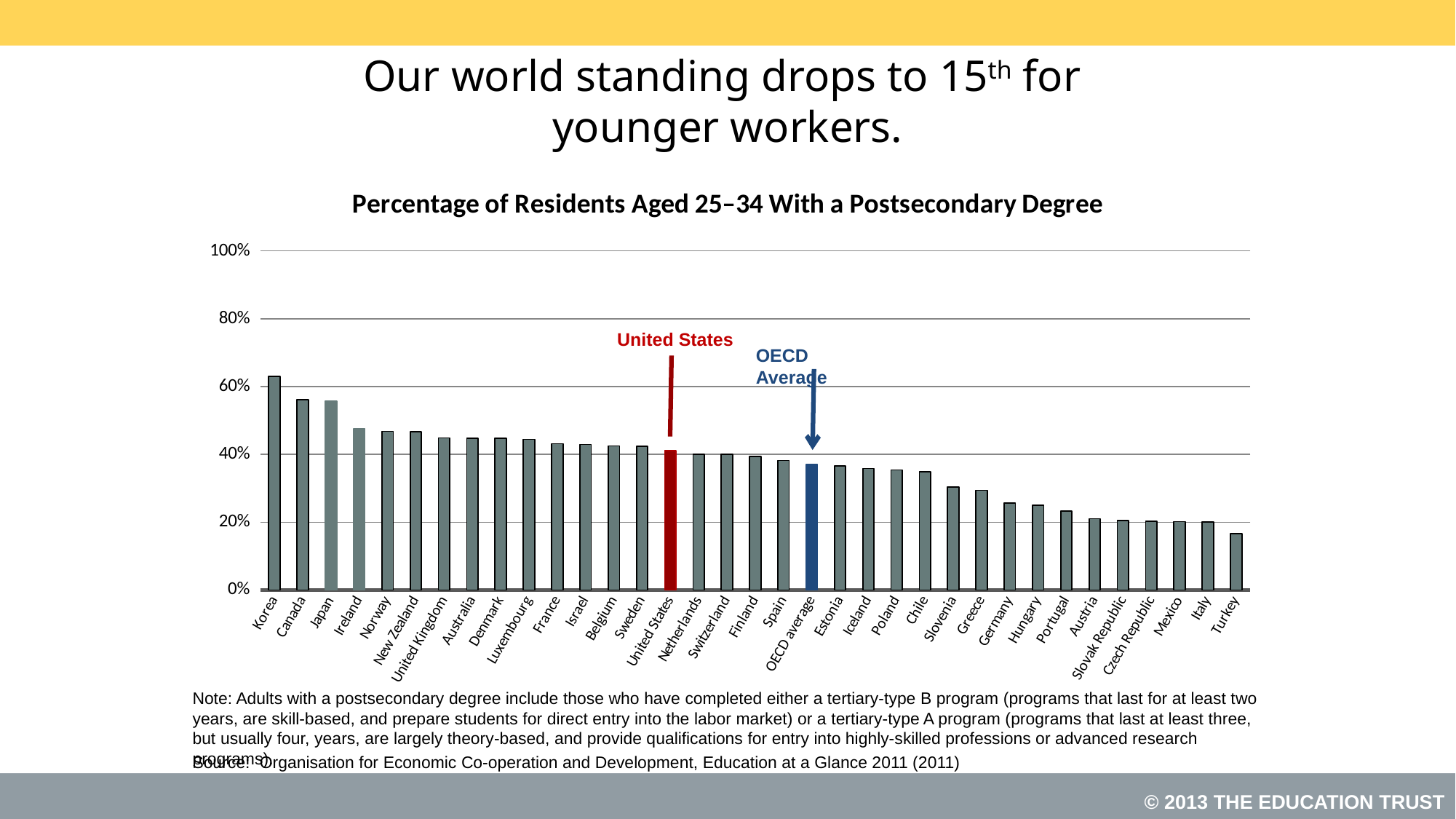
Which has a larger value, Chile or Slovenia? Chile Is the value for Turkey greater or less than 20%? less Which country has the highest percentage of residents aged 25–34 with a postsecondary degree? Korea Is the value for OECD average greater or less than 40%? less What colour is the bar for the United States? red Which has a larger value, Korea or Canada? Korea Is the value for Mexico greater or less than 40%? less What is the title of the chart? Percentage of Residents Aged 25–34 With a Postsecondary Degree What kind of chart is shown on the slide? bar chart Which country has the lowest percentage of residents aged 25–34 with a postsecondary degree? Turkey Do the values rise or fall moving from left to right along the x axis? fall